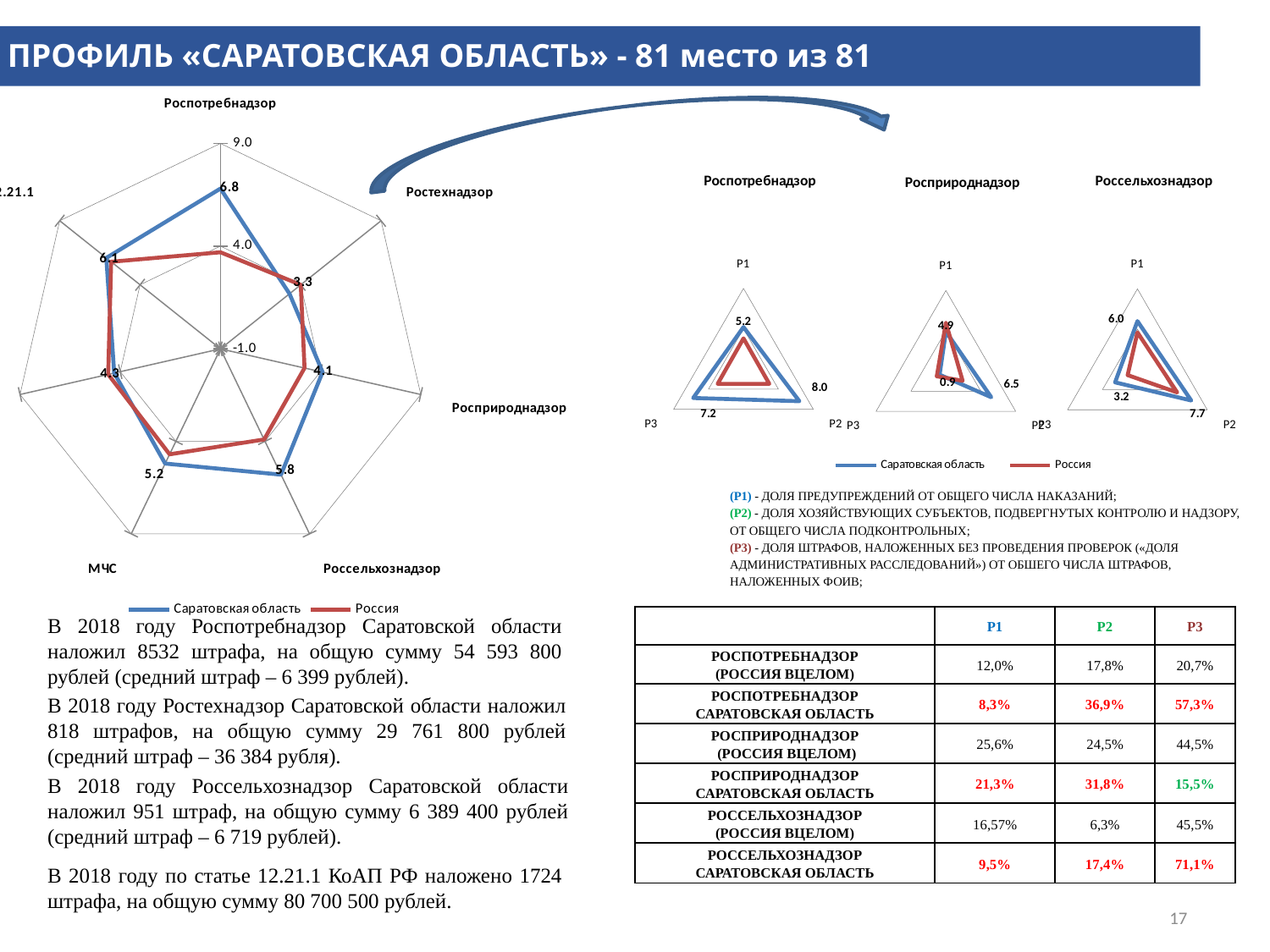
In the large radar chart on the left, what is the difference between the Саратовская область values for Роспотребнадзор and Ростехнадзор? 3.5 What kind of chart is the large chart on the left of the slide? Radar chart In the large radar chart on the left, on which labelled axis does Саратовская область have its highest value? Роспотребнадзор In the small radar chart titled Роспотребнадзор, what is the value for Саратовская область at P2? 8.0 In the large radar chart on the left, which series has the larger value on the Роспотребнадзор axis, Саратовская область or Россия? Саратовская область How many series does the legend of the large radar chart on the left list? 2 In the small radar chart titled Россельхознадзор, which is larger for Саратовская область, the value at P1 or at P3? P1 How many points (axes) does each of the three small radar charts on the right have? 3 In the small radar chart titled Россельхознадзор, what is the value for Саратовская область at P2? 7.7 In the large radar chart on the left, what is the value for Саратовская область on the Роспотребнадзор axis? 6.8 In the large radar chart on the left, what is the value for Саратовская область on the Ростехнадзор axis? 3.3 In the small radar chart titled Росприроднадзор, at which point does Саратовская область have its lowest value? P3